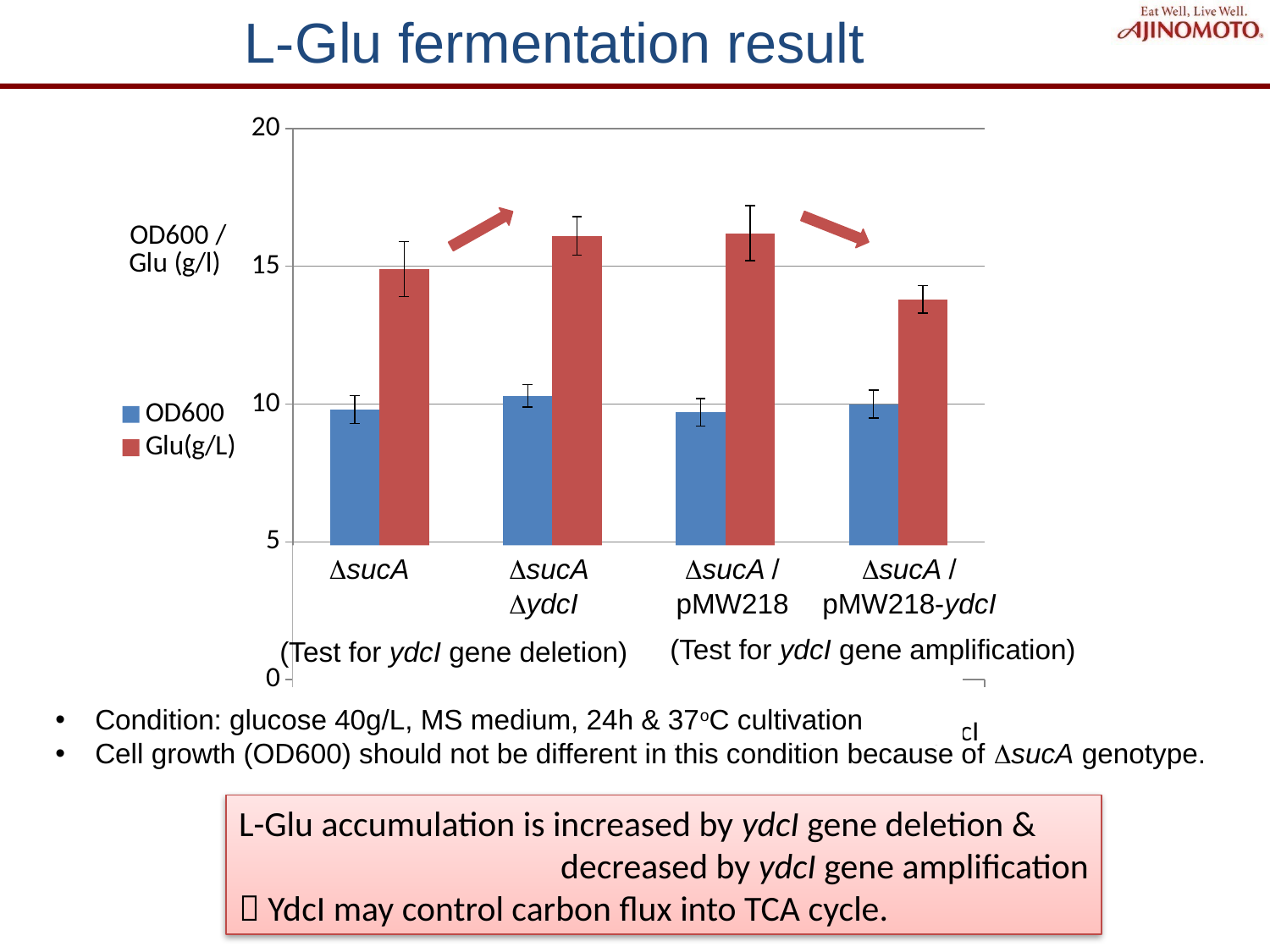
Is the Glu(g/L) value for ΔsucA greater or less than 10? greater Which series is shown in red in the chart? Glu(g/L) Is the Glu(g/L) value for ΔsucA / pMW218-ydcI greater or less than 15? less Which has the larger Glu(g/L) value: ΔsucA ΔydcI or ΔsucA / pMW218-ydcI? ΔsucA ΔydcI Which category has the lowest Glu(g/L) value? ΔsucA / pMW218-ydcI What is the label on the vertical axis of the chart? OD600 / Glu (g/l) How many categories (strains) are plotted on the x axis? 4 Is the OD600 value for ΔsucA / pMW218 greater or less than 15? less How many series does the chart legend list? 2 What kind of chart is shown on the slide? bar chart For ΔsucA ΔydcI, which is larger: the OD600 value or the Glu(g/L) value? Glu(g/L)